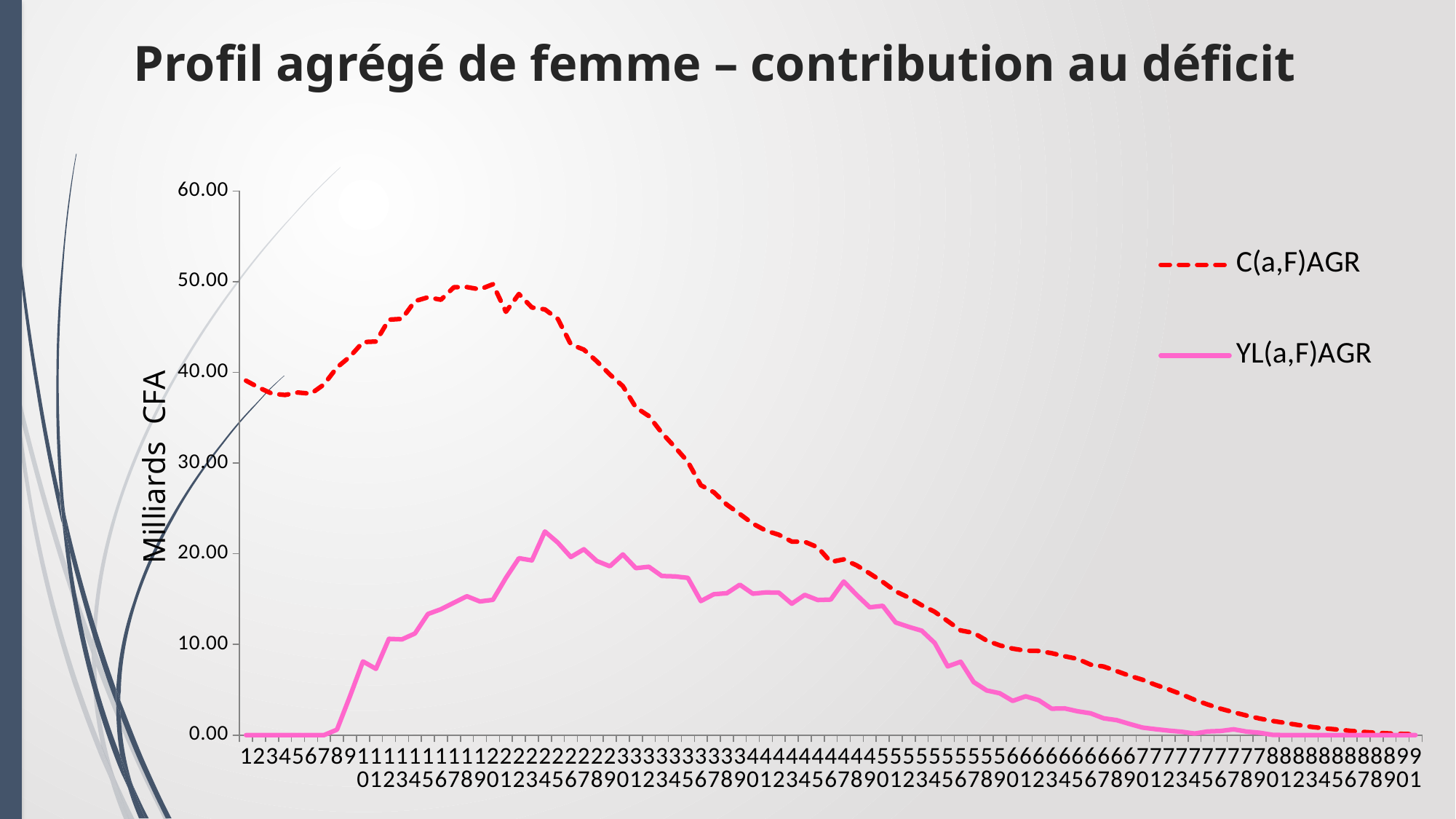
How many series does the legend list? 2 At age 20, which series has the higher value, C(a,F)AGR or YL(a,F)AGR? C(a,F)AGR Is the value of C(a,F)AGR at age 1 greater or less than 30.00? greater Is the value of YL(a,F)AGR at age 1 greater or less than 10.00? less Which series reaches the higher peak value, C(a,F)AGR or YL(a,F)AGR? C(a,F)AGR Does the C(a,F)AGR series rise or fall between age 30 and age 90? fall Is the value of C(a,F)AGR at age 50 greater or less than 30.00? less What kind of chart is shown on the slide? line chart What are the two series named in the legend? C(a,F)AGR and YL(a,F)AGR What is the label on the vertical axis? Milliards CFA